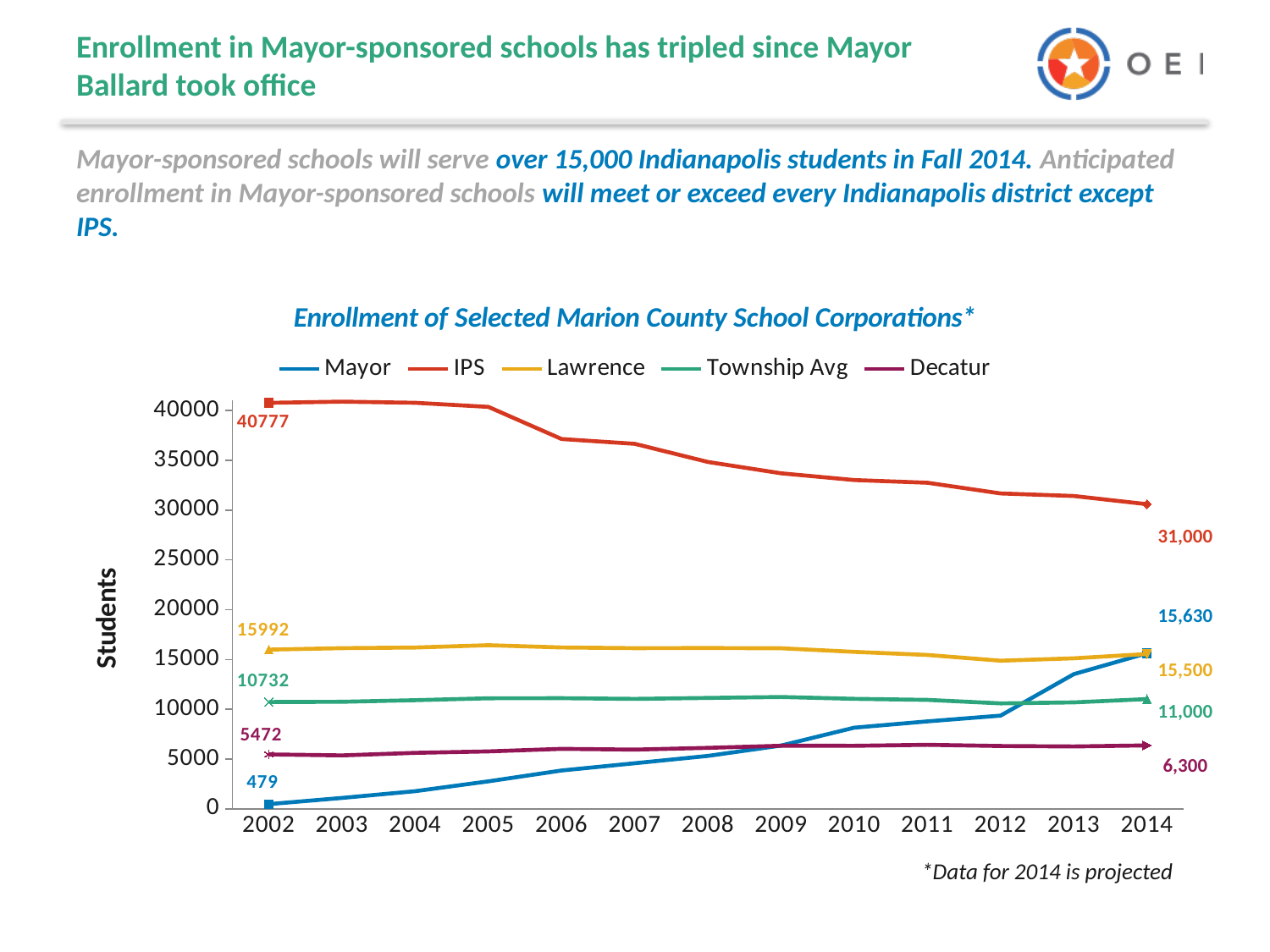
Does IPS enrollment rise or fall from 2002 to 2014? fall By how much did Mayor enrollment increase from 2002 to 2014? 15151 What is the projected Mayor enrollment in 2014? 15,630 Which series has the highest enrollment in 2014? IPS By how much did IPS enrollment fall from 2002 to 2014? 9777 Which series has the lowest enrollment in 2002? Mayor How many years are shown on the x axis? 13 How many series does the legend list? 5 Is the IPS enrollment in 2006 greater or less than 35000? greater What kind of chart is shown on the slide? line chart What was the IPS enrollment in 2002? 40777 What was the Decatur enrollment in 2002? 5472